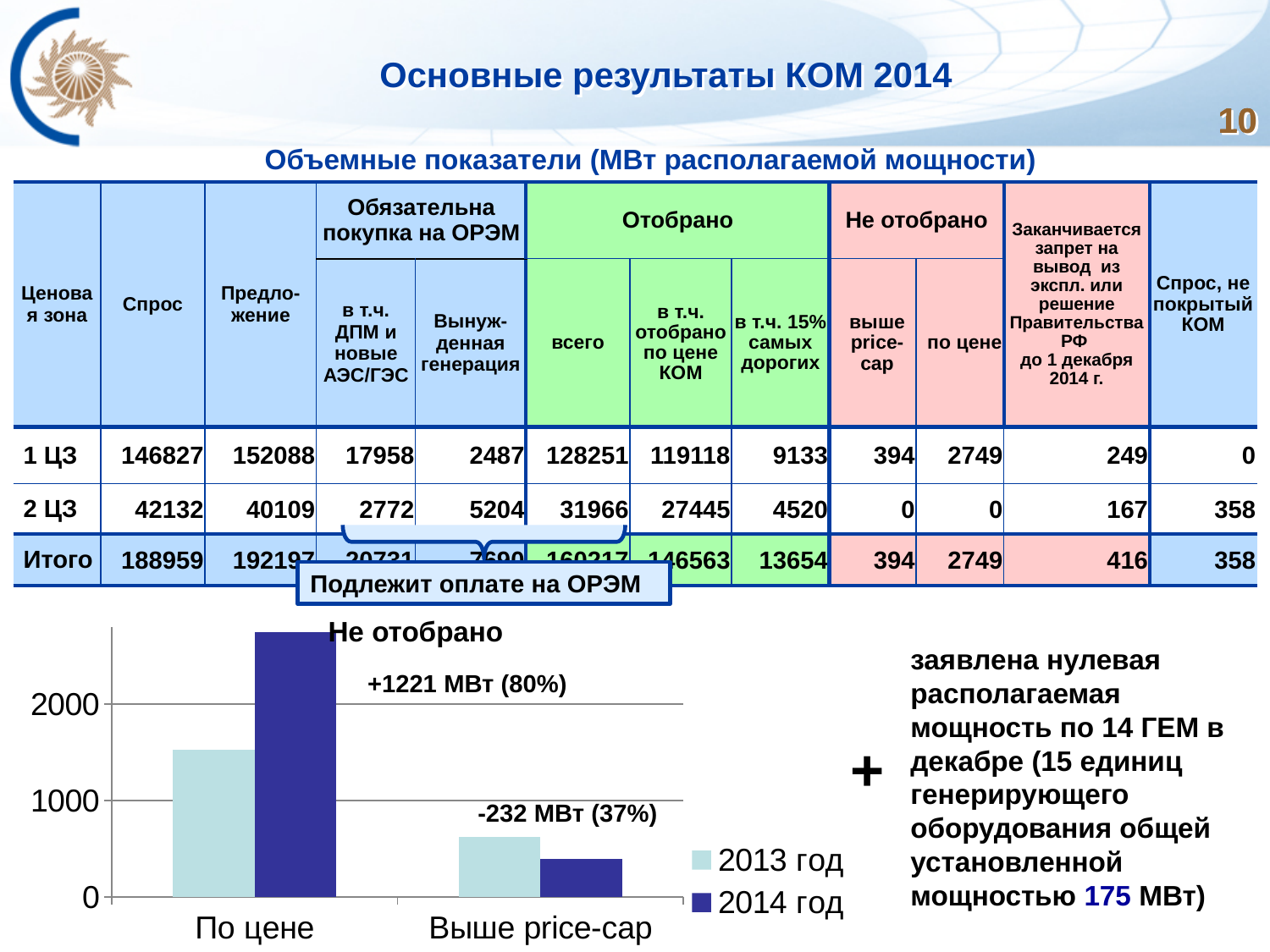
For Выше price-cap, which year has the larger value, 2013 год or 2014 год? 2013 год For По цене, which year has the larger value, 2013 год or 2014 год? 2014 год What kind of chart is shown on the slide? bar chart How many categories are shown on the x axis of the chart? 2 Is the 2013 год value for Выше price-cap greater or less than 1000? less What change from 2013 to 2014 is annotated on the chart for По цене? +1221 МВт (80%) Is the 2014 год value for По цене greater or less than 2000? greater Which series is shown in dark blue in the chart? 2014 год What is the title of the bar chart? Не отобрано Which bar in the chart is the shortest? 2014 год, Выше price-cap How many series does the chart legend list? 2 Which bar in the chart is the tallest? 2014 год, По цене